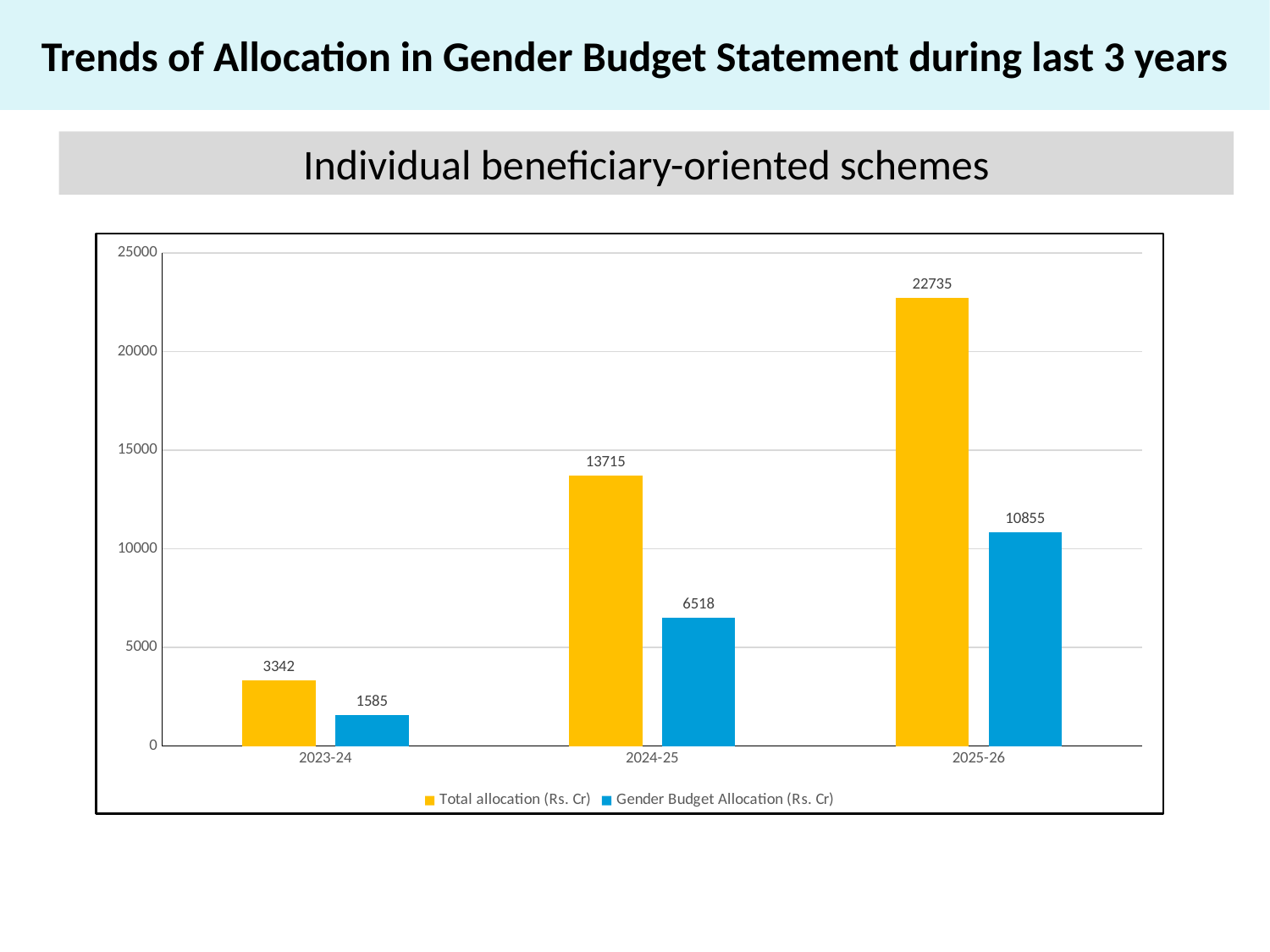
How many series does the legend list? 2 How many years are shown on the x axis? 3 What is the difference between the Total allocation in 2024-25 and in 2023-24? 10373 Which year has the lowest Gender Budget Allocation (Rs. Cr)? 2023-24 Is the Total allocation for 2025-26 greater or less than 20000? greater Which year has the highest Total allocation (Rs. Cr)? 2025-26 What kind of chart is shown on the slide? Bar chart Which is larger: the Gender Budget Allocation in 2025-26 or the Total allocation in 2024-25? Total allocation in 2024-25 What is the difference between the Total allocation and the Gender Budget Allocation in 2025-26? 11880 What is the Total allocation (Rs. Cr) for 2024-25? 13715 What is the Gender Budget Allocation (Rs. Cr) for 2025-26? 10855 What is the Gender Budget Allocation (Rs. Cr) for 2023-24? 1585